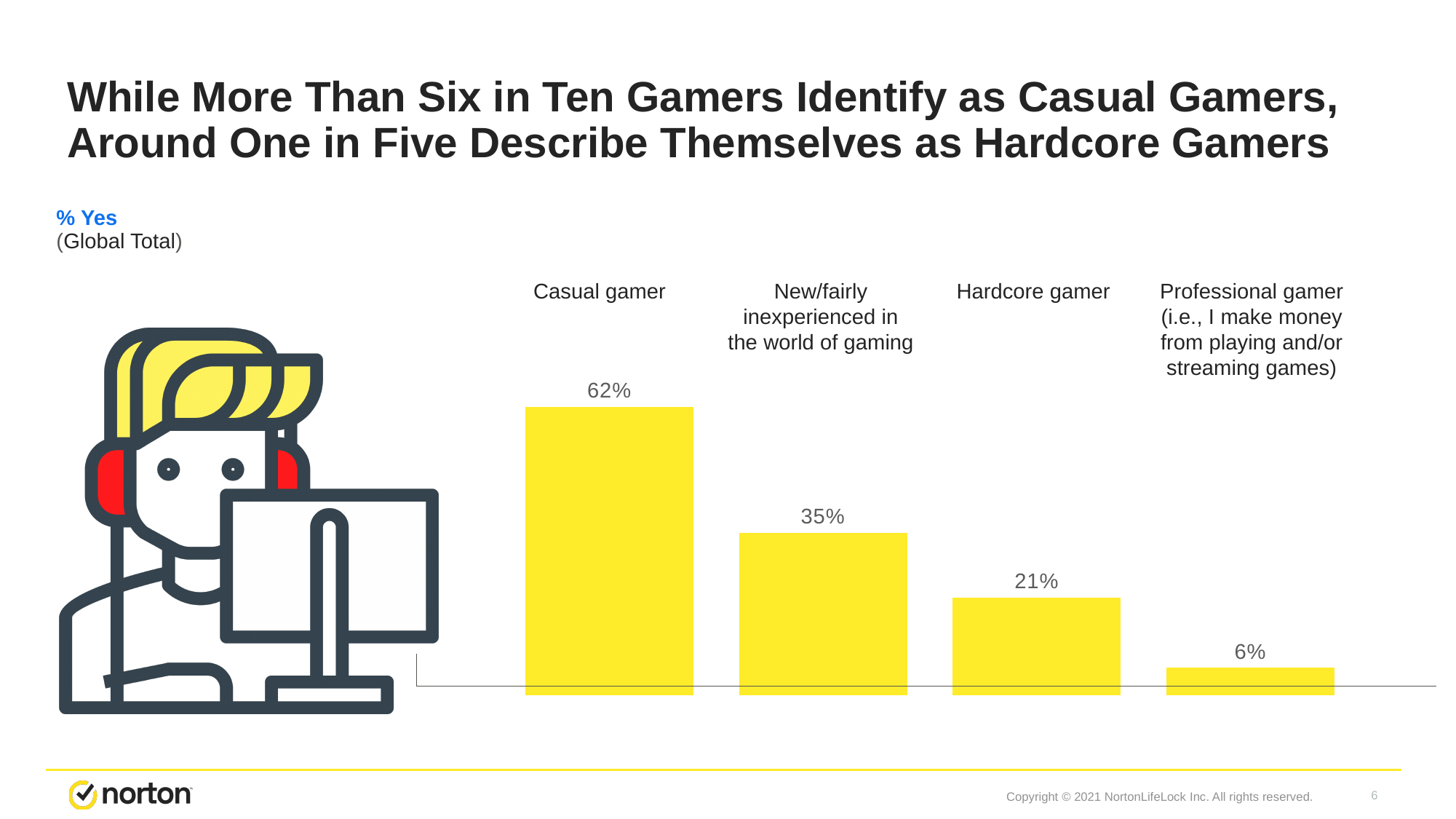
What is the difference between the new/fairly inexperienced and professional gamer percentages? 29% How many categories are shown in the chart? 4 What percentage of gamers identify as a casual gamer? 62% What percentage of gamers identify as a professional gamer? 6% Which category has the lowest value in the chart? Professional gamer What percentage of gamers identify as new/fairly inexperienced in the world of gaming? 35% What is the difference between the casual gamer and hardcore gamer percentages? 41% Which is larger: the value for new/fairly inexperienced gamers or for hardcore gamers? New/fairly inexperienced Do the values rise or fall from left to right across the chart? Fall What type of chart is shown on the slide? Bar chart Which category has the highest value in the chart? Casual gamer What percentage of gamers describe themselves as a hardcore gamer? 21%